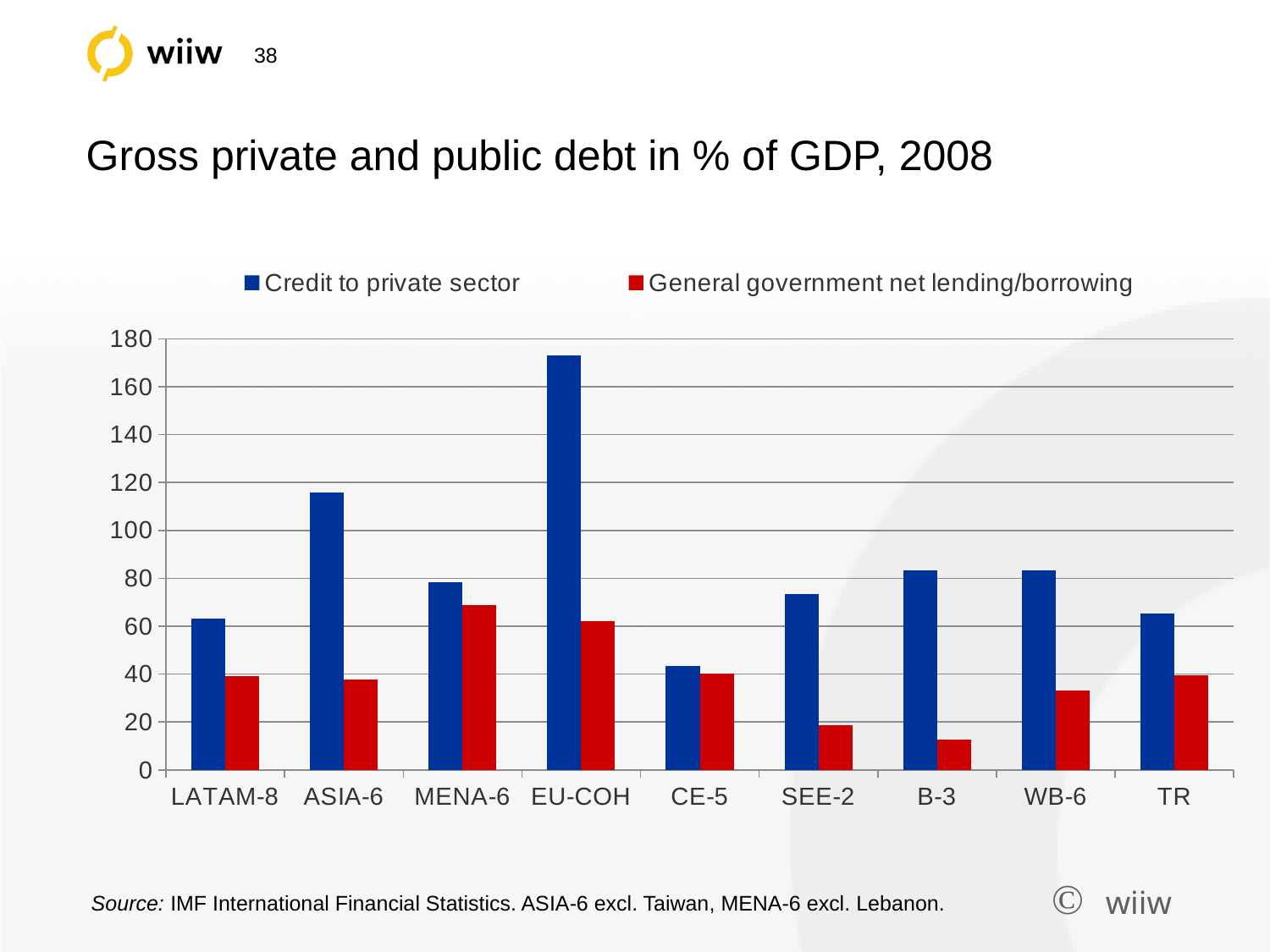
Which group has the highest value for General government net lending/borrowing? MENA-6 Is the Credit to private sector value for ASIA-6 greater or less than 100? greater Which group has the lowest value for Credit to private sector? CE-5 What colour are the bars for General government net lending/borrowing? red Is the General government net lending/borrowing value for B-3 greater or less than 20? less How many regional groups are shown on the x axis? 9 Which group has the highest value for Credit to private sector? EU-COH Which group has the lowest value for General government net lending/borrowing? B-3 How many series does the legend list? 2 Is the Credit to private sector value for EU-COH greater or less than 160? greater What kind of chart is shown on the slide? bar chart Which is larger, the Credit to private sector value for ASIA-6 or for MENA-6? ASIA-6